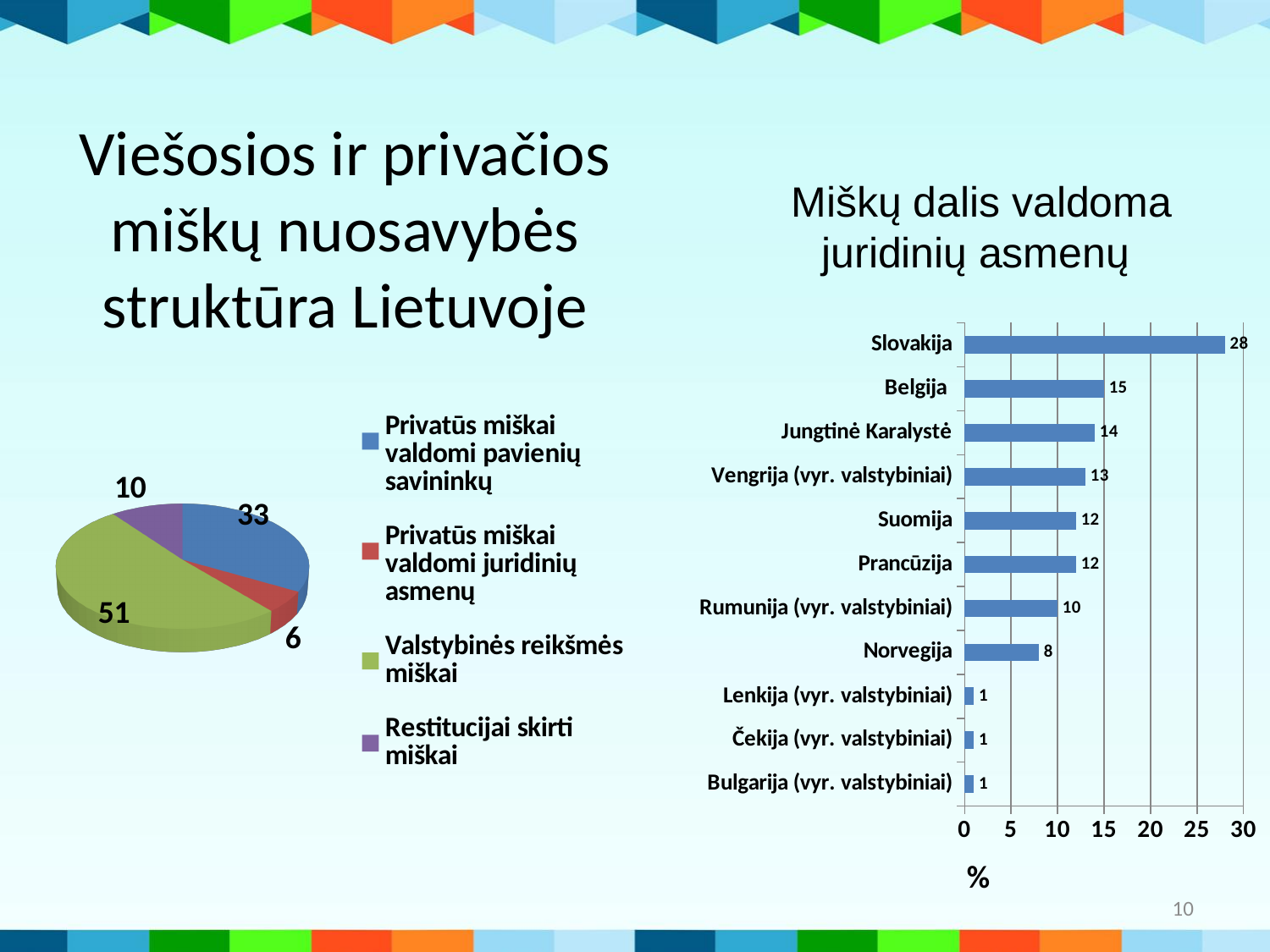
In the bar chart titled 'Miškų dalis valdoma juridinių asmenų', what is the value for Slovakija? 28 In the bar chart titled 'Miškų dalis valdoma juridinių asmenų', which is larger, the value for Jungtinė Karalystė or the value for Rumunija (vyr. valstybiniai)? Jungtinė Karalystė In the pie chart on the left of the slide, what is the value for 'Privatūs miškai valdomi juridinių asmenų'? 6 In the bar chart titled 'Miškų dalis valdoma juridinių asmenų', what is the difference between the values for Slovakija and Belgija? 13 In the pie chart on the left of the slide, what is the value for 'Valstybinės reikšmės miškai'? 51 In the bar chart titled 'Miškų dalis valdoma juridinių asmenų', which country has the highest value? Slovakija What kind of chart is the chart titled 'Miškų dalis valdoma juridinių asmenų'? Bar chart In the pie chart on the left of the slide, which category has the smallest slice? Privatūs miškai valdomi juridinių asmenų How many categories does the legend of the pie chart on the left of the slide list? 4 How many countries are shown in the bar chart titled 'Miškų dalis valdoma juridinių asmenų'? 11 In the bar chart titled 'Miškų dalis valdoma juridinių asmenų', what unit is shown on the horizontal axis? % In the bar chart titled 'Miškų dalis valdoma juridinių asmenų', what is the value for Norvegija? 8